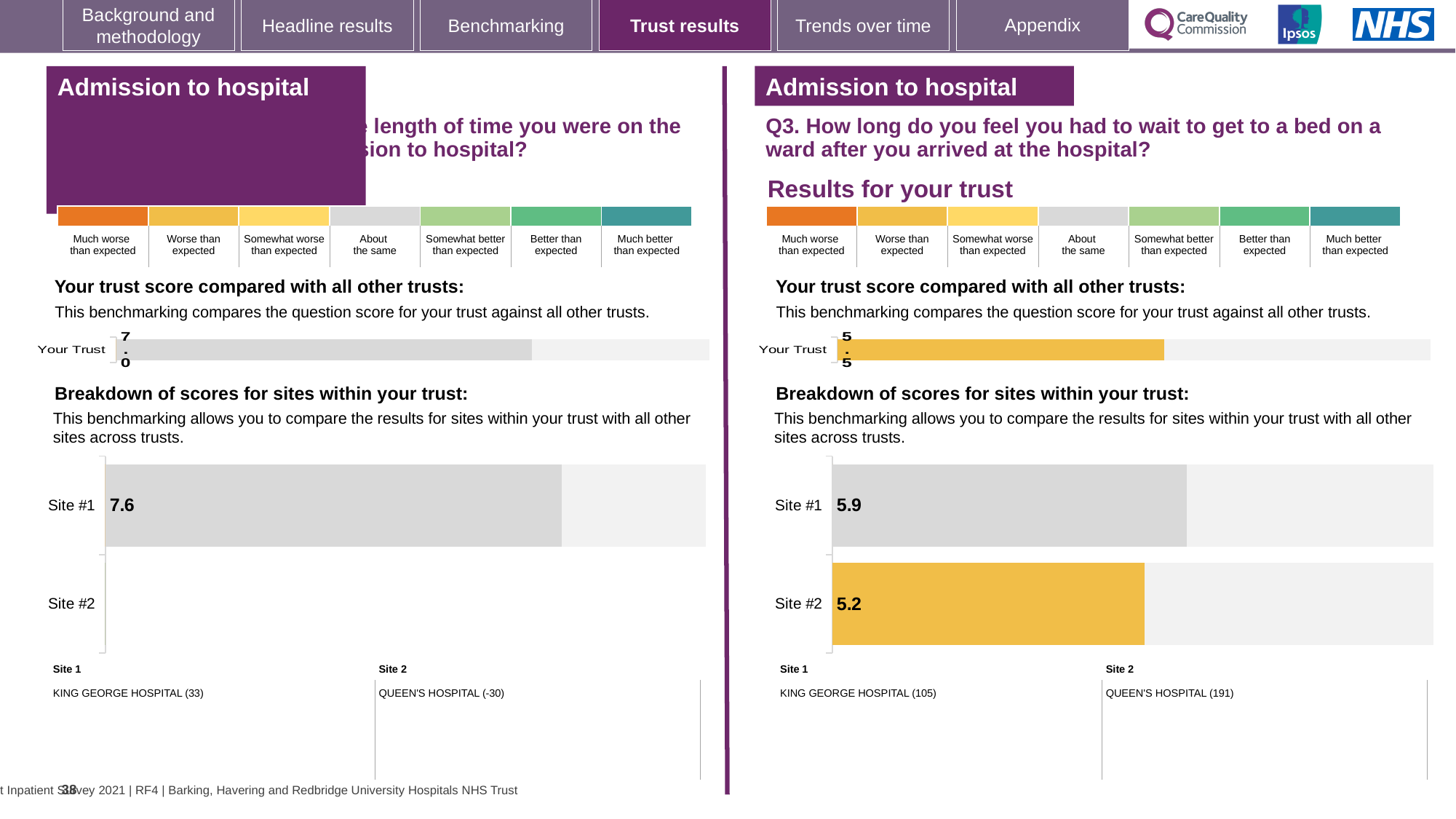
On the right-hand side breakdown chart (Q3), what colour is the bar for Site #2? yellow On the right-hand 'Your trust score compared with all other trusts' chart (Q3), what is the score for Your Trust? 5.5 On the left-hand side breakdown chart, what is the score for Site #1? 7.6 On the right-hand side breakdown chart (Q3), is the score for Site #1 larger or smaller than the score for Site #2? larger On the right-hand side breakdown chart (Q3), what is the score for Site #2? 5.2 How many sites are listed on the right-hand side breakdown chart (Q3)? 2 On the right-hand side breakdown chart (Q3), which site has the higher score? Site #1 On the left-hand 'Your trust score compared with all other trusts' chart, what is the score for Your Trust? 7.0 On the right-hand side breakdown chart (Q3), what is the difference between the Site #1 and Site #2 scores? 0.7 On the right-hand side breakdown chart (Q3), what is the score for Site #1? 5.9 What kind of chart is used for the breakdown of scores for sites on the right-hand side (Q3)? bar chart On the right-hand side breakdown chart (Q3), which site has the lower score? Site #2